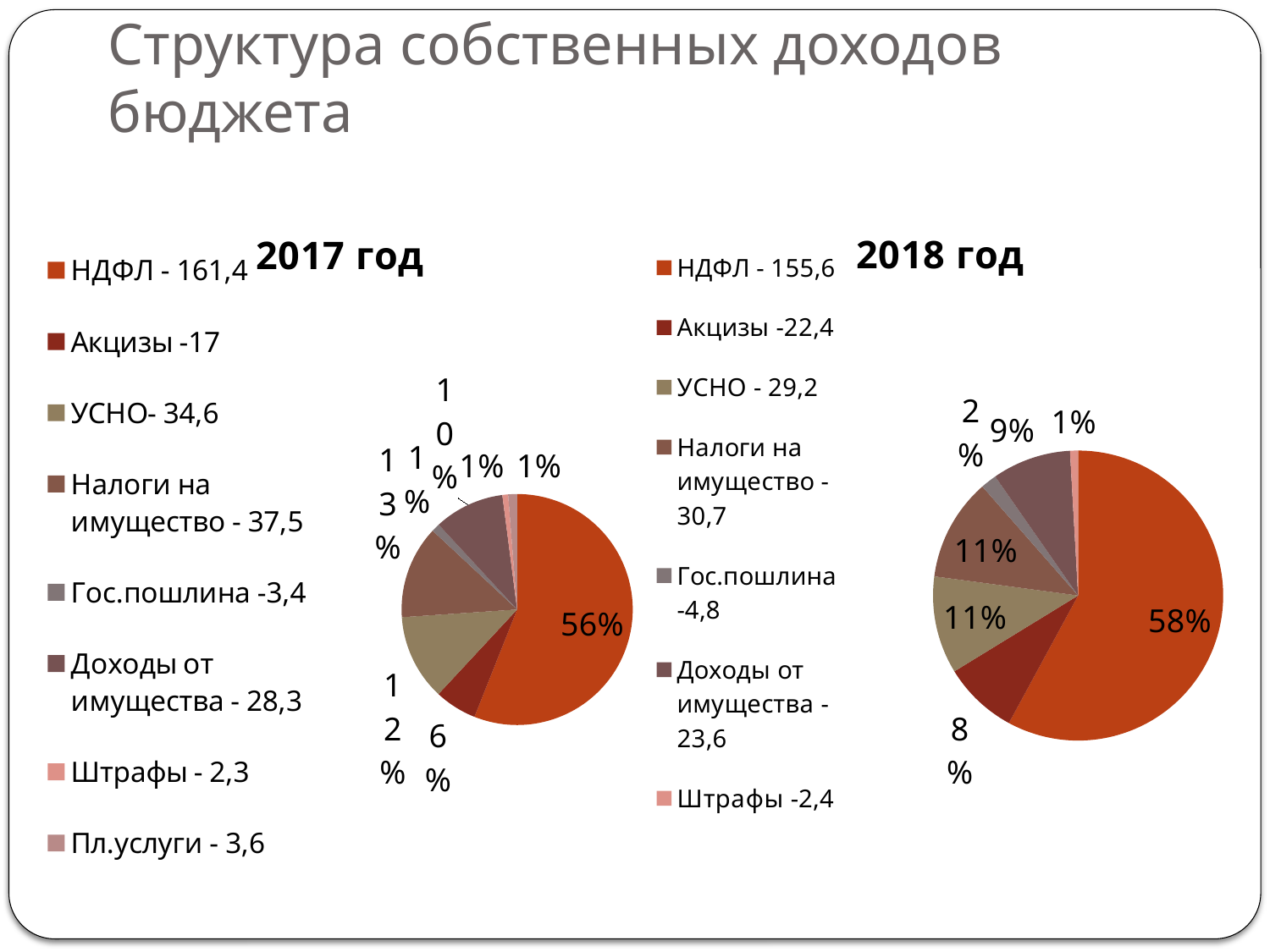
In the 2018 год chart, which category has the largest slice? НДФЛ How many categories does the legend of the 2018 год chart list? 7 In the 2017 год chart, what share of the pie does НДФЛ have? 56% In the 2017 год chart, which category has the largest slice? НДФЛ Which is larger: the НДФЛ share in the 2017 год chart or in the 2018 год chart? 2018 год In the 2018 год chart, what share of the pie does Акцизы have? 8% In the 2018 год chart, what share of the pie does НДФЛ have? 58% What kind of chart is the 2017 год chart? pie chart In the 2018 год chart, what value is shown next to УСНО in the legend? 29,2 In the 2017 год chart, what value is shown next to НДФЛ in the legend? 161,4 How many categories does the legend of the 2017 год chart list? 8